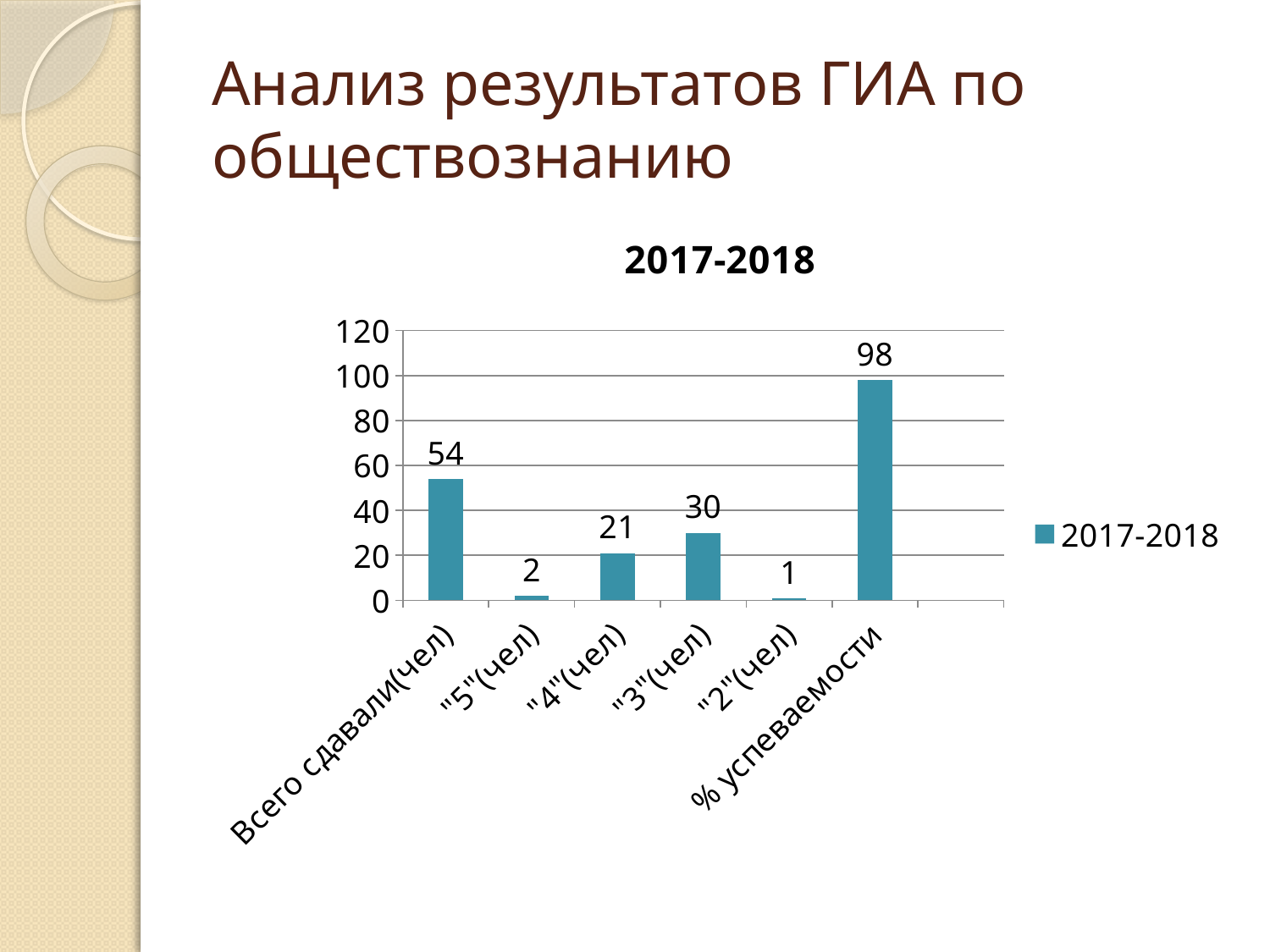
Which is larger, the value for ""5"(чел)" or the value for ""3"(чел)"? "3"(чел) What is the value for "Всего сдавали(чел)"? 54 Is the value for "Всего сдавали(чел)" greater or less than 40? greater What is the difference between the values for ""3"(чел)" and ""4"(чел)"? 9 What is the value for ""4"(чел)"? 21 Which category has the lowest value? "2"(чел) What kind of chart is shown on the slide? bar chart What is the value for "% успеваемости"? 98 Which category has the highest value? % успеваемости How many categories are shown on the x axis? 6 What is the value for ""2"(чел)"? 1 What is the title of the chart? 2017-2018